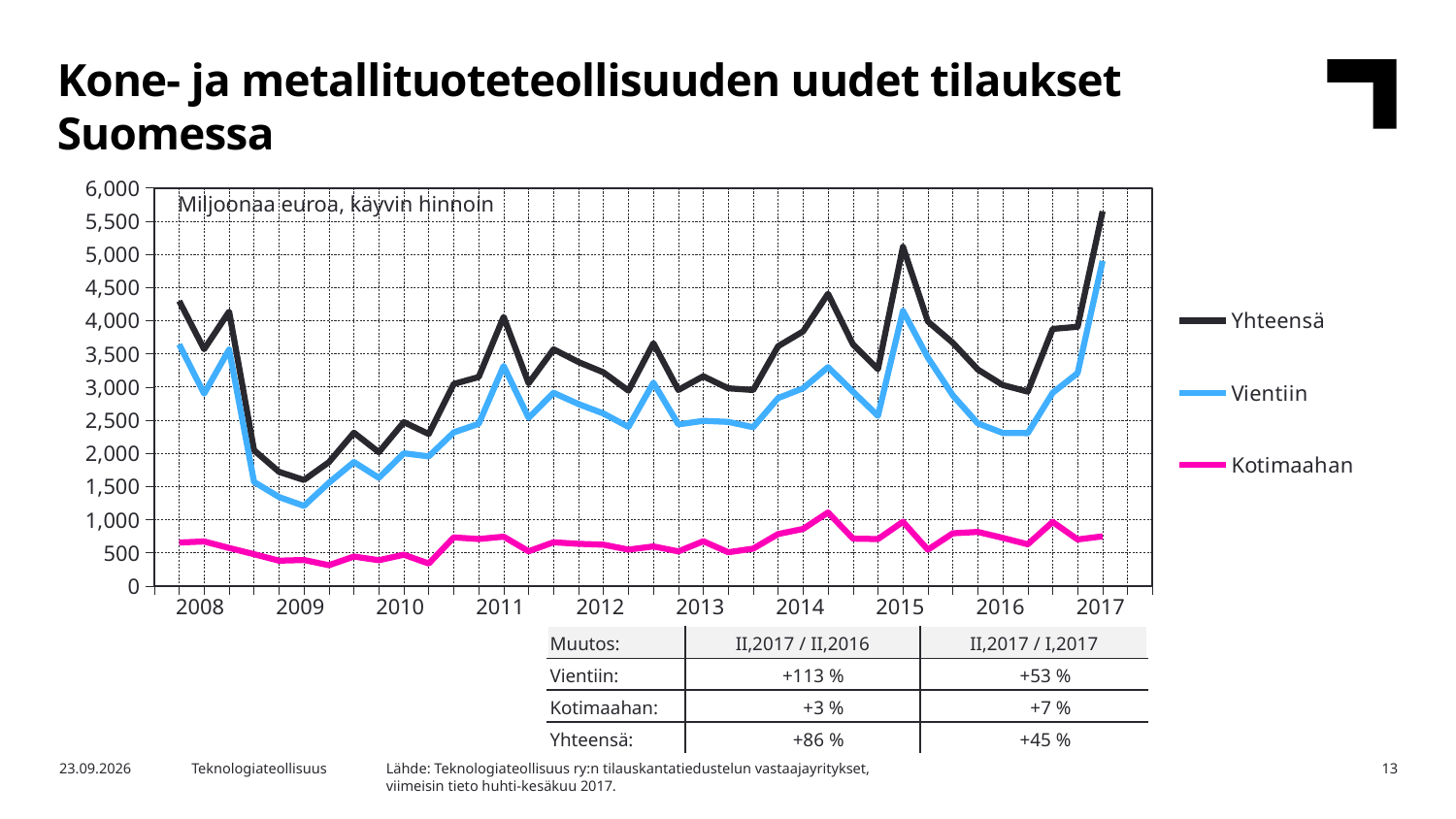
What are the three series named in the legend? Yhteensä, Vientiin, Kotimaahan What kind of chart is shown on the slide? Line chart Which series reaches the highest value on the chart? Yhteensä How many years are labelled on the x axis? 10 What unit note is printed inside the chart area? Miljoonaa euroa, käyvin hinnoin Is the highest value for Kotimaahan greater or less than 1,500? less Is the value for Vientiin at the last point in 2017 greater or less than 4,500? greater Which is larger at the end of 2017, Yhteensä or Vientiin? Yhteensä Does the Yhteensä line rise or fall from 2016 to the end of 2017? rise Is the value for Yhteensä at the last point in 2017 greater or less than 5,000? greater Which series stays lowest across the whole period? Kotimaahan How many series does the legend list? 3